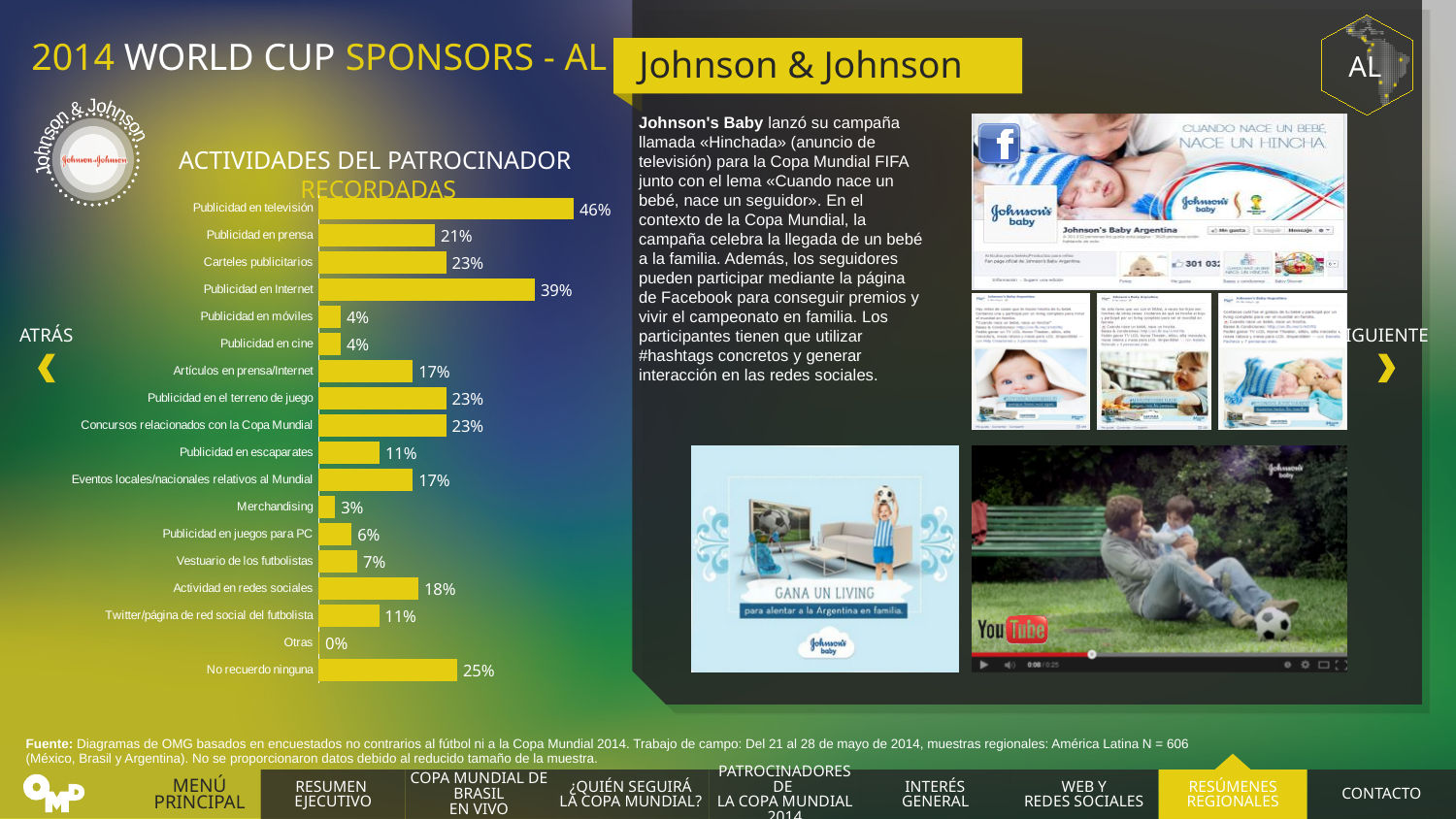
What type of chart is shown on the slide? Bar chart What is the value for "Publicidad en Internet"? 39% What is the title of the chart? ACTIVIDADES DEL PATROCINADOR RECORDADAS What is the value for "Publicidad en televisión"? 46% What is the difference between "Vestuario de los futbolistas" and "Merchandising"? 4% What is the value for "No recuerdo ninguna"? 25% What is the value for "Actividad en redes sociales"? 18% How many categories are shown in the chart? 18 What is the difference between "Publicidad en televisión" and "Publicidad en Internet"? 7% Which is larger, "Publicidad en prensa" or "Carteles publicitarios"? Carteles publicitarios Which category has the lowest value? Otras Which category has the highest value? Publicidad en televisión